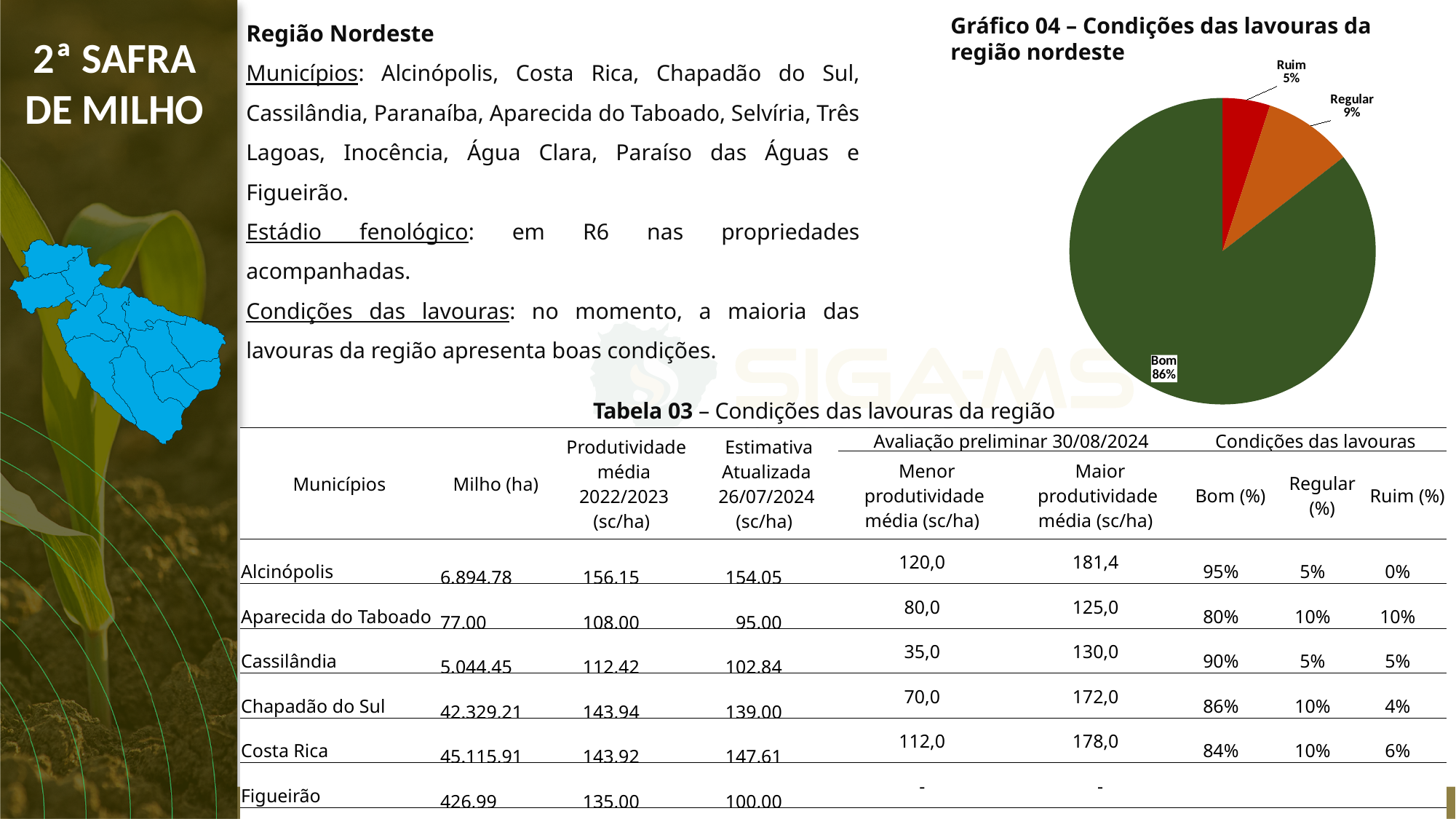
How many slices does the pie chart have? 3 Which slice of the pie chart is the largest? Bom What share of the pie does the Bom slice represent? 86% What is the difference in percentage points between the Regular and Ruim slices? 4 What is the title of the pie chart? Gráfico 04 – Condições das lavouras da região nordeste What kind of chart is Gráfico 04? pie chart What share of the pie does the Regular slice represent? 9% Which slice of the pie chart is the smallest? Ruim Which is larger in the pie chart, the Regular slice or the Ruim slice? Regular What is the difference in percentage points between the Bom and Regular slices? 77 What share of the pie does the Ruim slice represent? 5% What colour is the Bom slice in the pie chart? dark green